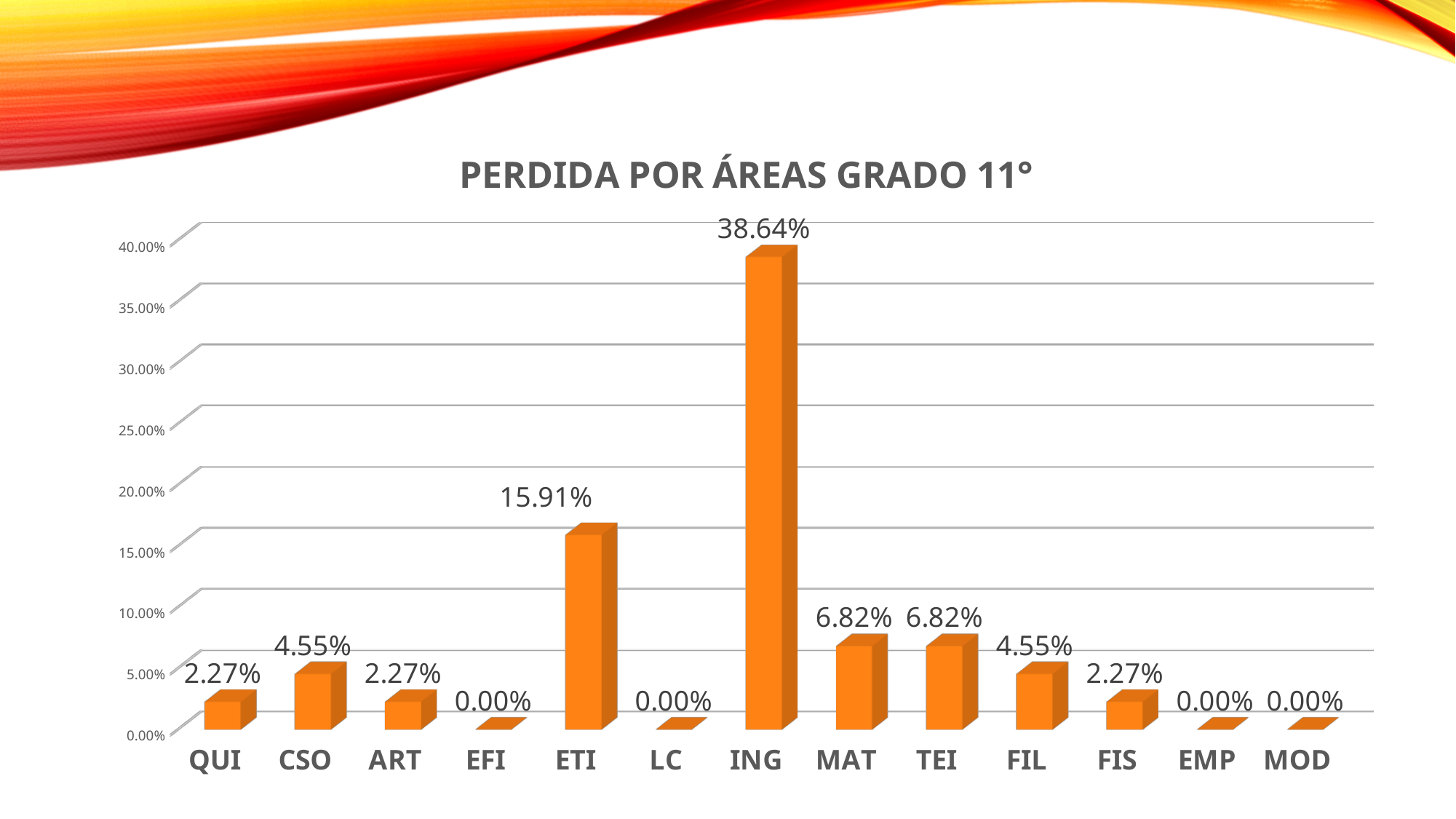
Which is larger, the value for CSO or the value for ART? CSO What type of chart is shown on the slide? Bar chart What is the value for ING? 38.64% How many categories are shown on the x axis? 13 What is the value for CSO? 4.55% What is the value for FIS? 2.27% Is the value for ETI greater or less than 10.00%? greater What is the difference between the values for MAT and FIL? 2.27% Which category has the highest value? ING What is the value for ETI? 15.91% What is the difference between the values for ING and ETI? 22.73% How many categories have a value of 0.00%? 4